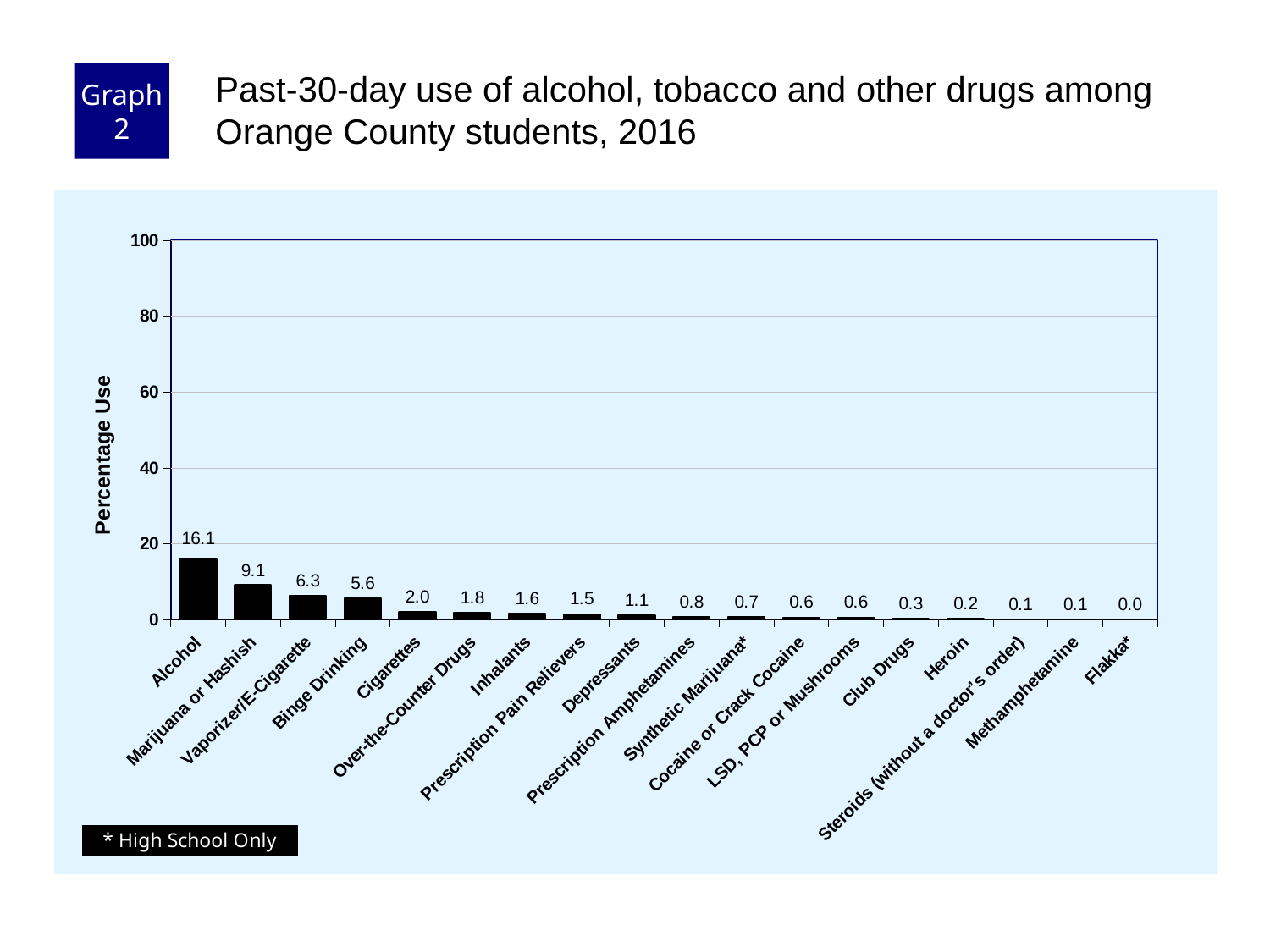
What is the label of the y axis? Percentage Use Which category has the lowest percentage use? Flakka* What is the difference in percentage use between Alcohol and Marijuana or Hashish? 7.0 Which has a higher percentage use, Binge Drinking or Inhalants? Binge Drinking What kind of chart is shown on the slide? Bar chart How many categories are shown on the x axis? 18 Which category has the highest percentage use? Alcohol Is the value for Marijuana or Hashish greater or less than 20? less What is the percentage use for Cigarettes? 2.0 What is the percentage use for Alcohol? 16.1 What is the percentage use for Heroin? 0.2 What is the percentage use for Vaporizer/E-Cigarette? 6.3